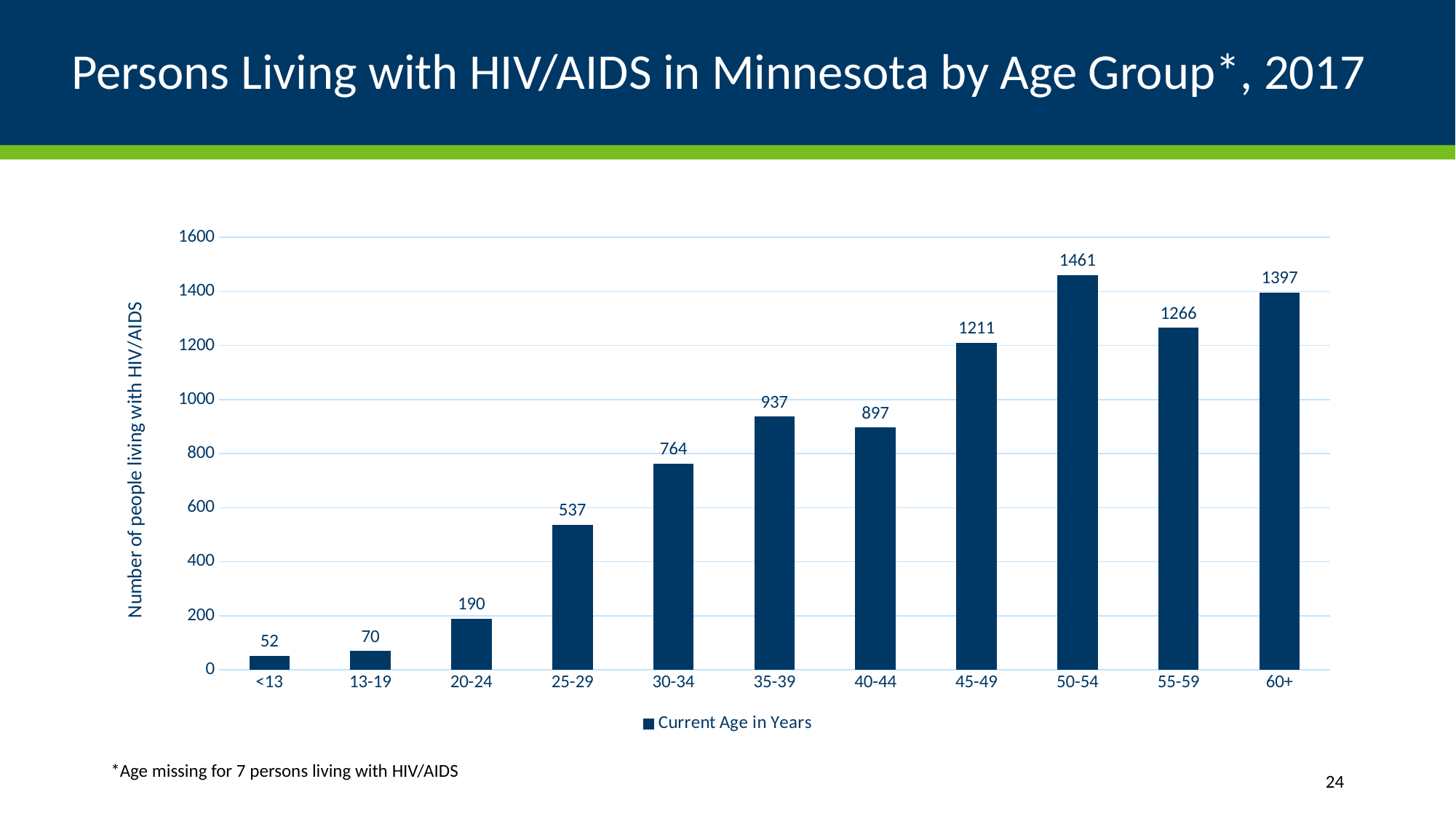
Which is larger, the value for 60+ or the value for 55-59? 60+ Which age group has the lowest number of people living with HIV/AIDS? <13 What is the value for the 25-29 age group? 537 What is the difference between the values for the 35-39 and 40-44 age groups? 40 How many age groups are shown on the chart? 11 What is the number of people living with HIV/AIDS in the 45-49 age group? 1211 What kind of chart is shown on the slide? bar chart What is the value for the <13 age group? 52 Which age group has the highest number of people living with HIV/AIDS? 50-54 What is the label of the y axis? Number of people living with HIV/AIDS Is the value for the 30-34 age group greater or less than 800? less What is the difference between the values for the 50-54 and 55-59 age groups? 195